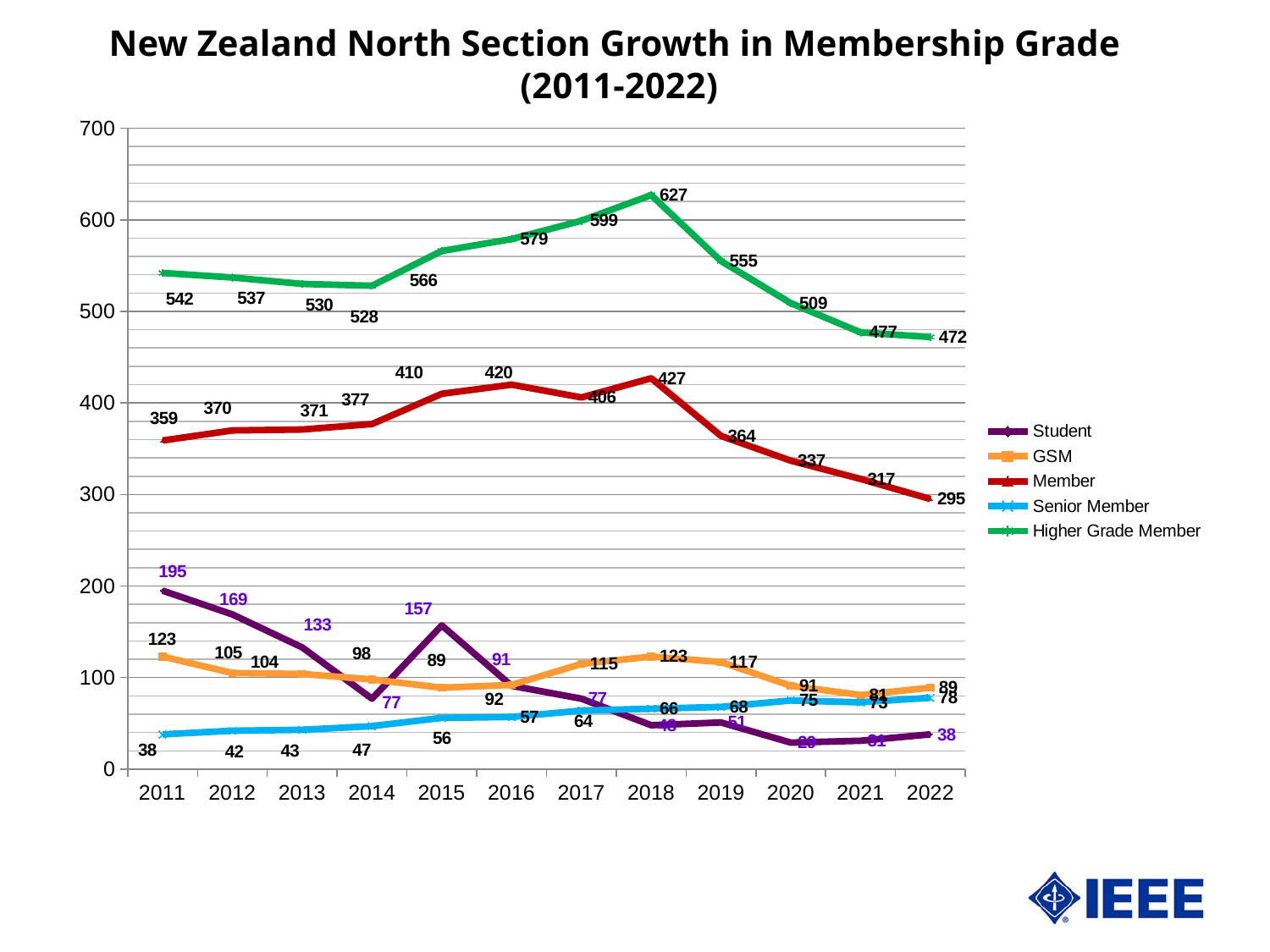
What is the difference between the Member value in 2018 and in 2022? 132 What is the Senior Member value in 2011? 38 How many series does the legend list? 5 How many years are plotted along the x axis? 12 In 2022, which is larger: GSM or Senior Member? GSM What is the Member value in 2022? 295 Does the Senior Member series generally rise or fall from 2011 to 2022? rise What kind of chart is shown on the slide? line chart What is the Higher Grade Member value in 2018? 627 In which year is the Member series at its lowest? 2022 In which year does the Higher Grade Member series reach its highest value? 2018 What is the Student value in 2011? 195